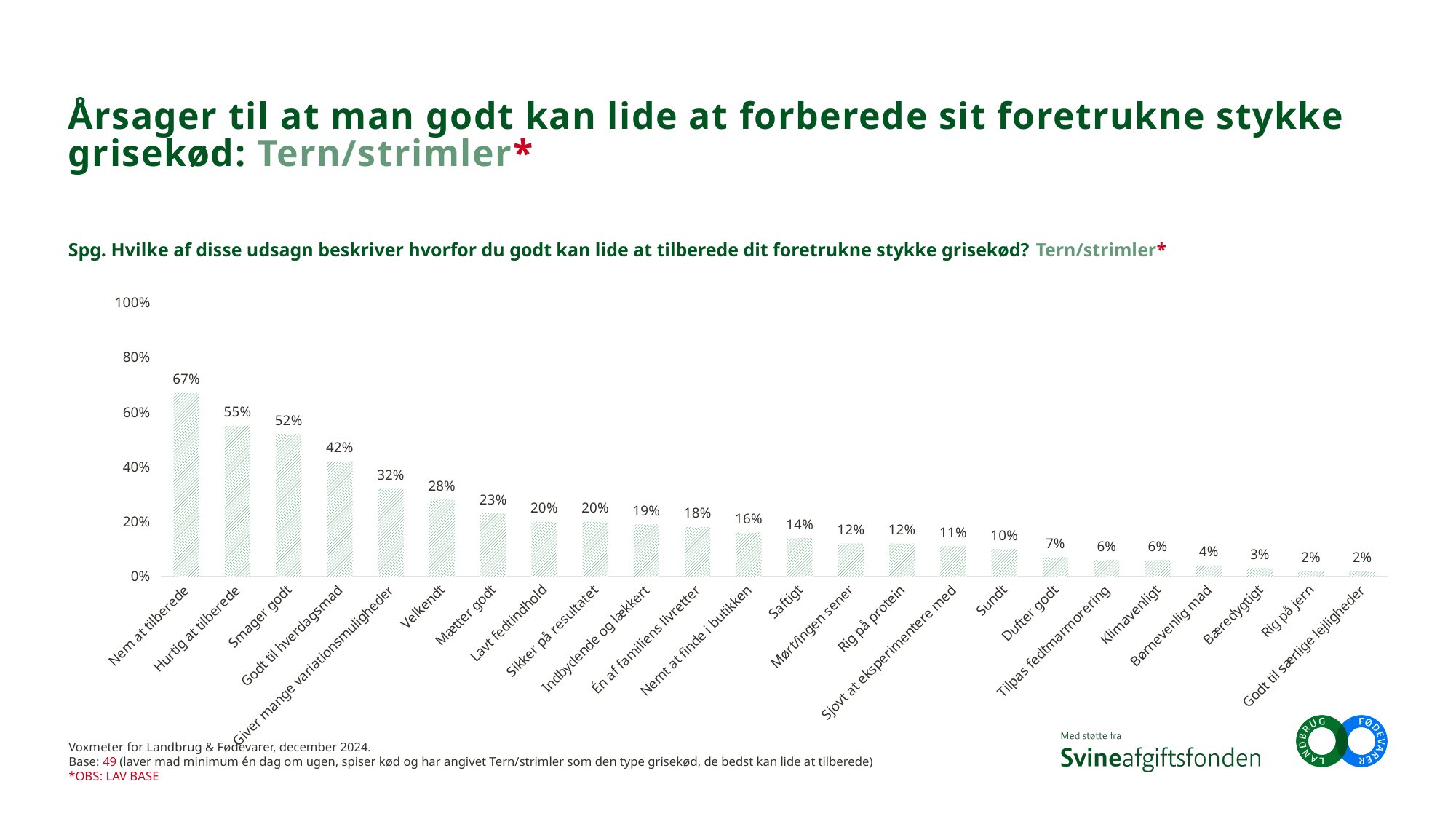
Do the values rise or fall from left to right along the x axis? fall How many categories are shown in the chart? 24 Which category has the highest value? Nem at tilberede Is the value for "Nem at tilberede" greater or less than 60%? greater Which is larger, "Giver mange variationsmuligheder" or "Mætter godt"? Giver mange variationsmuligheder What is the value for "Saftigt"? 14% What is the value for "Klimavenligt"? 6% What is the value for "Nem at tilberede"? 67% What is the difference between "Velkendt" and "Sundt"? 18% What is the value for "Godt til hverdagsmad"? 42% What kind of chart is shown on the slide? bar chart What is the difference between "Hurtigt at tilberede" and "Smager godt"? 3%